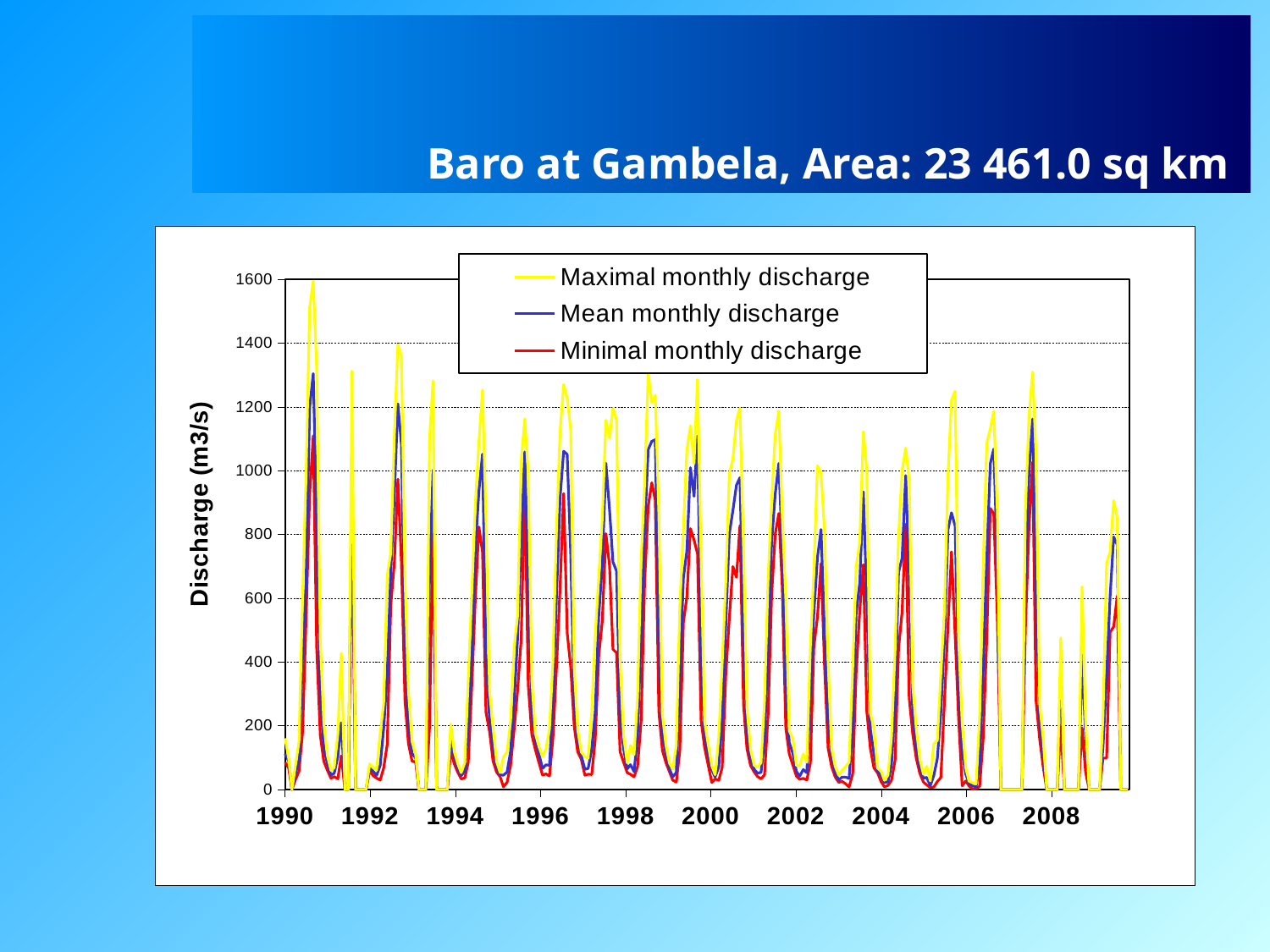
How many year labels are shown on the x axis? 10 Is the highest peak of the Minimal monthly discharge series greater or less than 1200? less Is the peak of the Mean monthly discharge series in 1990 greater or less than 1200? greater Which series reaches the highest value on the chart? Maximal monthly discharge What colour is the Mean monthly discharge line? blue How many series does the legend list? 3 In which year does the Maximal monthly discharge series reach its highest peak? 1990 Which series has the lowest values overall on the chart? Minimal monthly discharge What is the title of the y axis? Discharge (m3/s) Which is larger, the 1990 peak of the Maximal monthly discharge or the 1990 peak of the Mean monthly discharge? Maximal monthly discharge Is the highest peak of the Maximal monthly discharge series greater or less than 1400? greater What kind of chart is shown on the slide? line chart